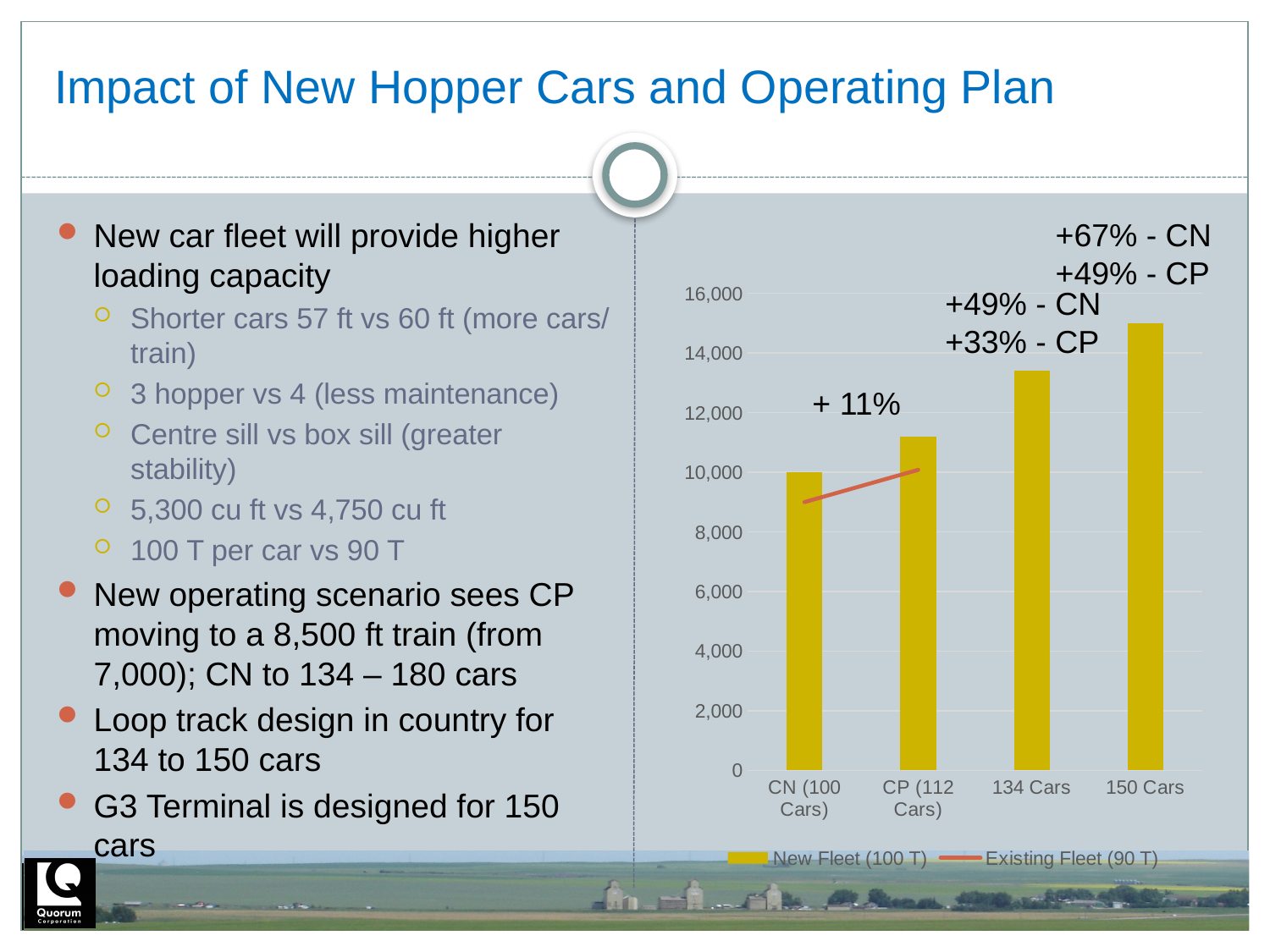
Which category has the lowest New Fleet (100 T) bar? CN (100 Cars) Which bar is taller, 134 Cars or CP (112 Cars)? 134 Cars What are the two legend entries of the chart? New Fleet (100 T) and Existing Fleet (90 T) How many categories are shown on the x axis of the chart? 4 Is the value for 150 Cars greater or less than 14,000? greater What is the value of the New Fleet (100 T) bar for CN (100 Cars)? 10,000 Do the bar values rise or fall from left to right along the x axis? rise Is the value for 134 Cars greater or less than 12,000? greater Is the value for CP (112 Cars) greater or less than 12,000? less Which category has the highest New Fleet (100 T) bar? 150 Cars How many series does the chart legend list? 2 What kind of chart is shown on the slide? combination bar and line chart